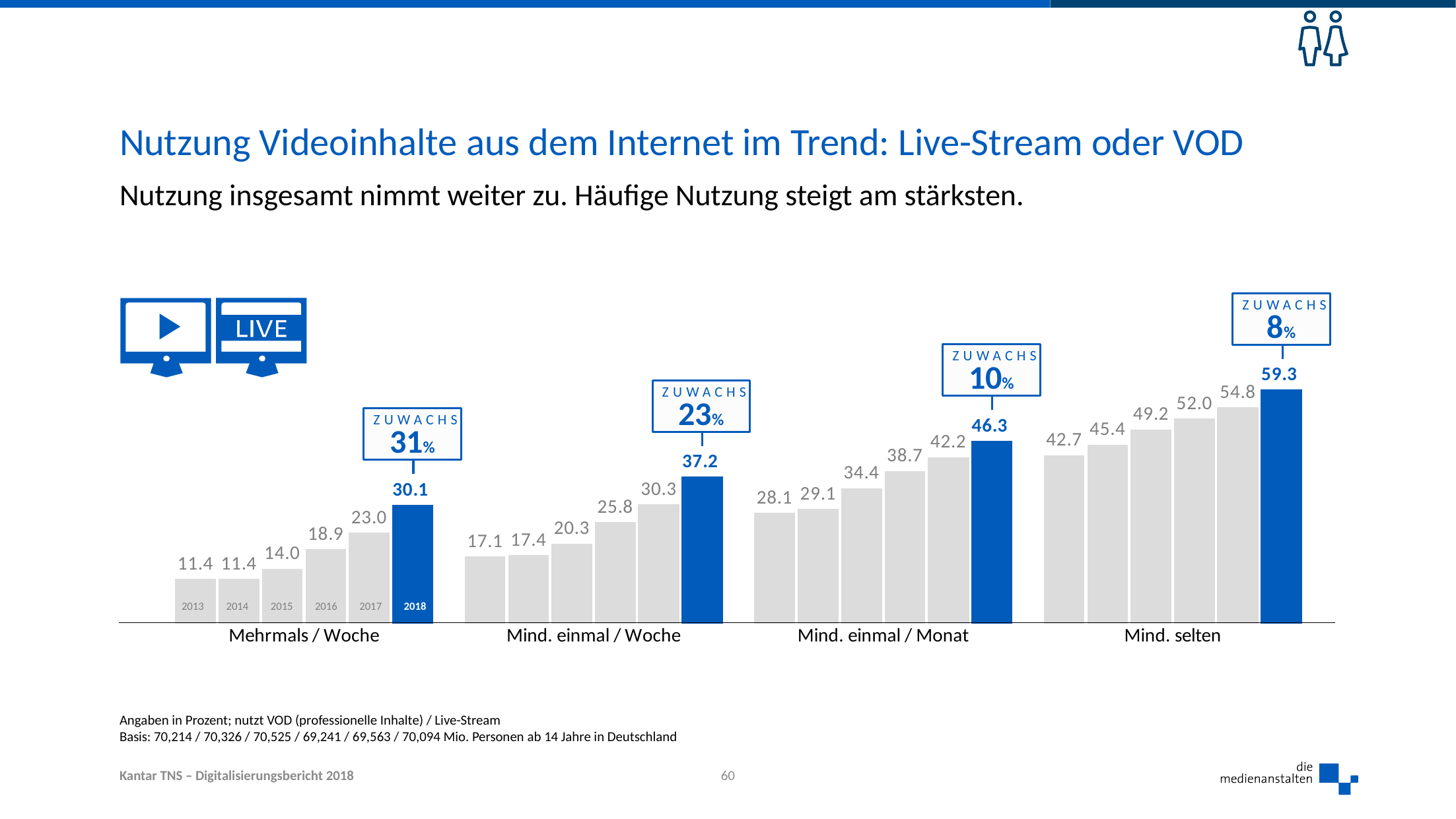
What "Zuwachs" percentage is shown above the "Mehrmals / Woche" group? 31% What is the 2013 value for "Mind. selten"? 42.7 What is the 2016 value for "Mind. einmal / Monat"? 38.7 What is the difference between the 2018 and 2017 values for "Mind. einmal / Woche"? 6.9 How many years are shown for each usage category? 6 Which is larger: the 2018 value for "Mind. einmal / Monat" or the 2013 value for "Mind. selten"? 2018 value for Mind. einmal / Monat Which usage category has the lowest 2013 value? Mehrmals / Woche What kind of chart is shown on the slide? Bar chart What is the 2018 value for "Mehrmals / Woche"? 30.1 What is the 2015 value for "Mind. einmal / Woche"? 20.3 Do the values for "Mind. selten" rise or fall from 2013 to 2018? Rise Which usage category has the highest 2018 value? Mind. selten